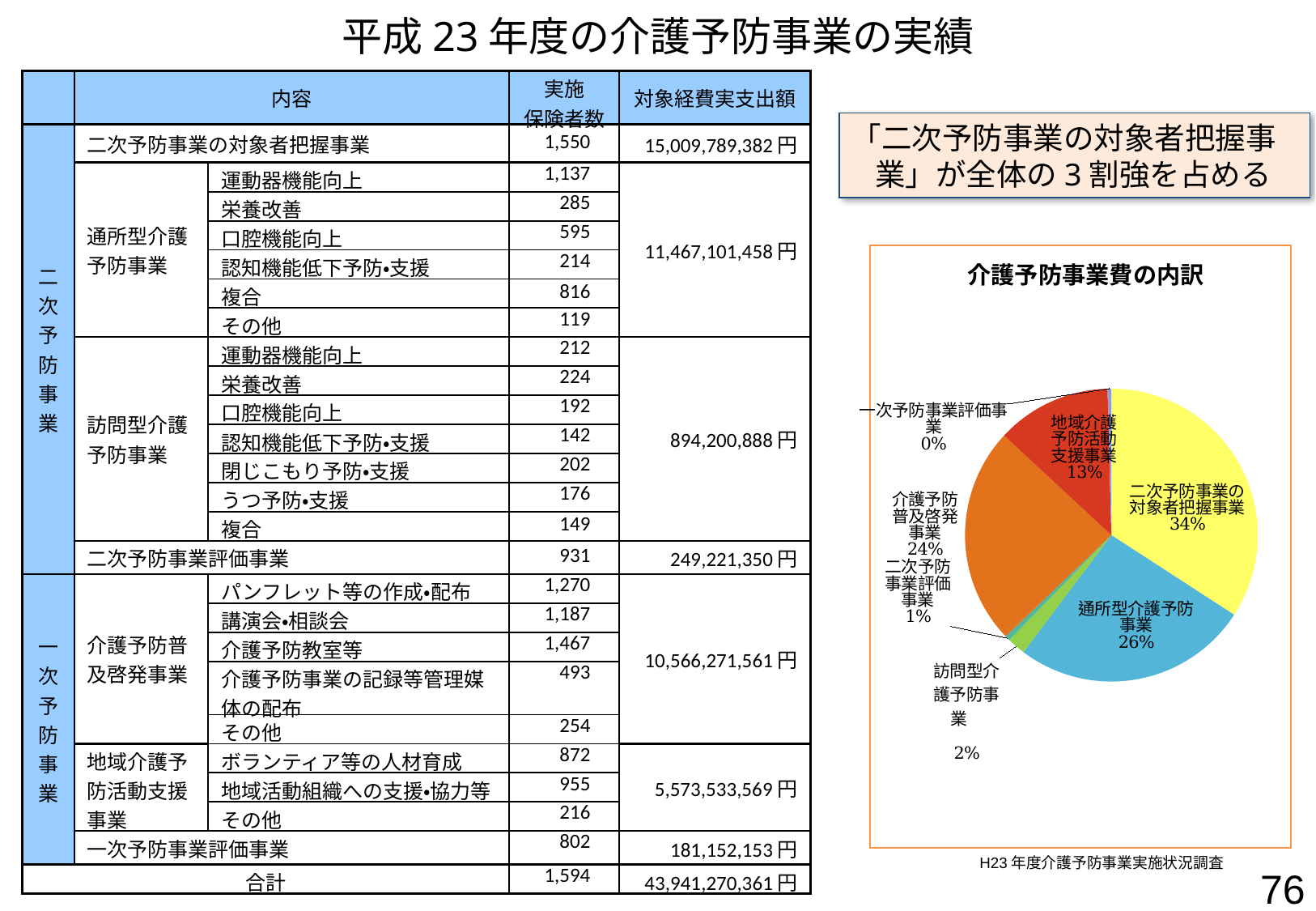
Which slice of the pie chart is the largest? 二次予防事業の対象者把握事業 In the pie chart, what is the difference in share between 通所型介護予防事業 and 地域介護予防活動支援事業? 13% In the pie chart, what share does 訪問型介護予防事業 account for? 2% How many slices does the pie chart have? 7 In the pie chart, what share does 通所型介護予防事業 account for? 26% In the pie chart, what share does 一次予防事業評価事業 account for? 0% What is the title of the chart on the slide? 介護予防事業費の内訳 What type of chart is shown on the slide? pie chart Which slice of the pie chart is the smallest? 一次予防事業評価事業